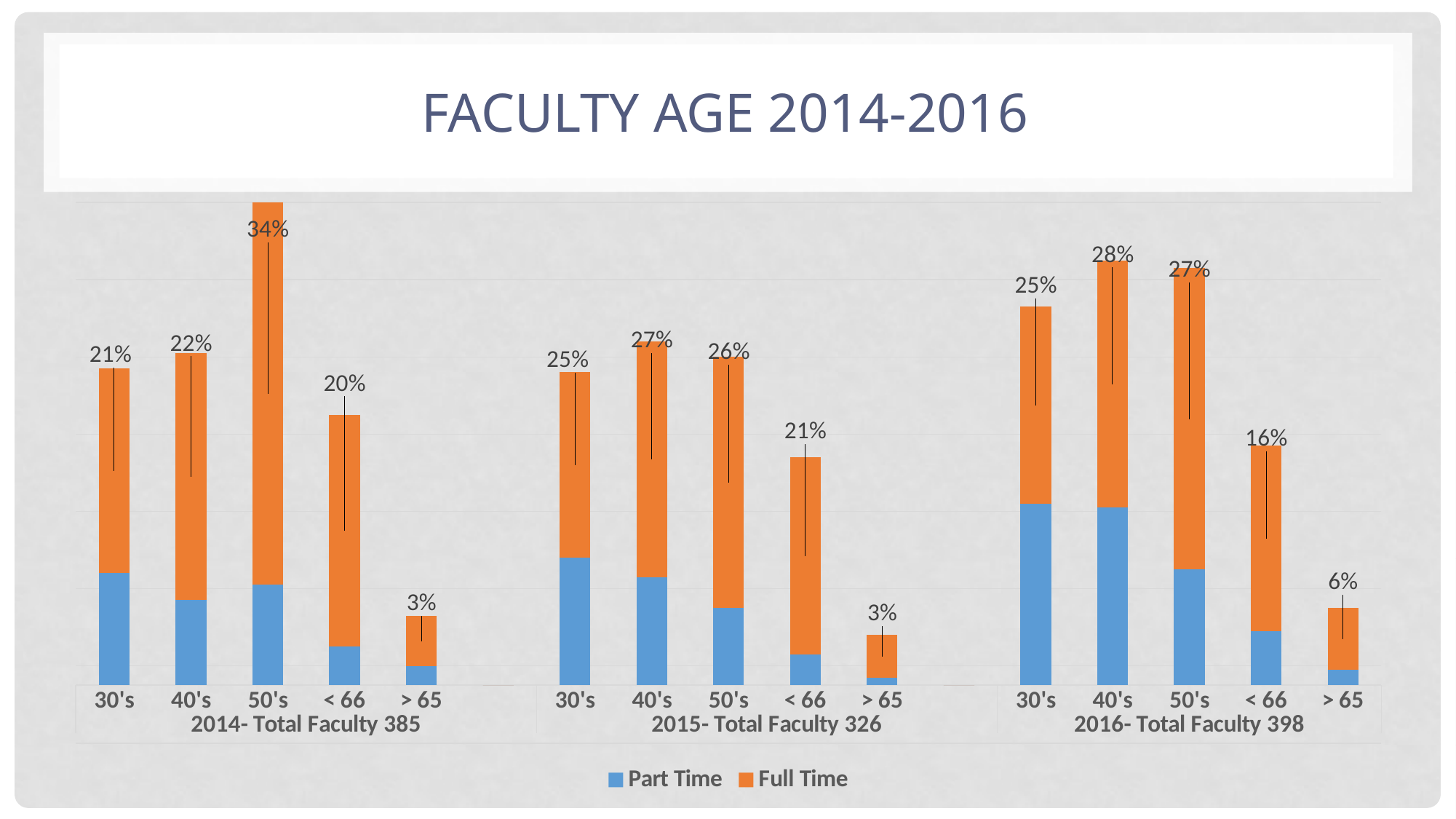
What percentage is shown for the > 65 age group in 2015? 3% What percentage is shown for the < 66 age group in 2016? 16% What kind of chart is shown on the slide? Stacked bar chart How many series does the legend list? 2 Which age group has the lowest percentage in 2015? > 65 What is the difference between the 50's and > 65 percentages in 2014? 31 percentage points Which age group has the highest percentage in 2014? 50's What total faculty number is given for 2015? 326 What percentage is shown for the 50's age group in 2014? 34% Is the > 65 percentage larger in 2014 or in 2016? 2016 How many age categories are shown for each year? 5 In 2015, which has the larger percentage, the 40's group or the 50's group? 40's